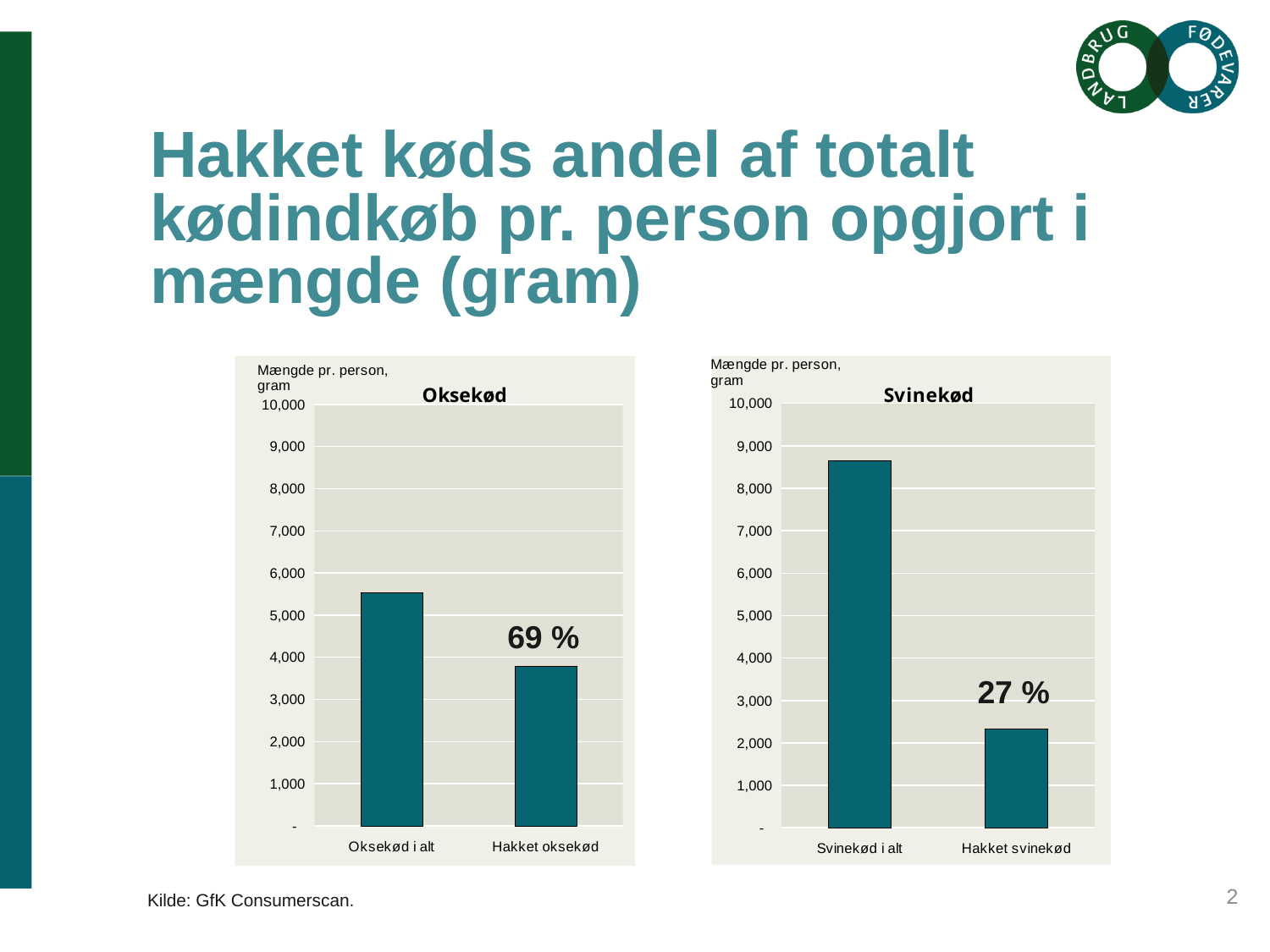
What type of chart is the Oksekød chart? bar chart How many bars are shown in the Svinekød chart? 2 In the Svinekød chart, what percentage label is shown above the Hakket svinekød bar? 27 % Which is larger: Svinekød i alt in the Svinekød chart or Oksekød i alt in the Oksekød chart? Svinekød i alt In the Svinekød chart, is the value for Svinekød i alt greater or less than 8,000? greater In the Oksekød chart, what percentage label is shown above the Hakket oksekød bar? 69 % In the Svinekød chart, is the value for Hakket svinekød greater or less than 3,000? less What is the y-axis label on the Oksekød chart? Mængde pr. person, gram In the Oksekød chart, is the value for Hakket oksekød greater or less than 4,000? less In the Svinekød chart, which category has the lower value? Hakket svinekød In the Oksekød chart, which category has the higher value? Oksekød i alt